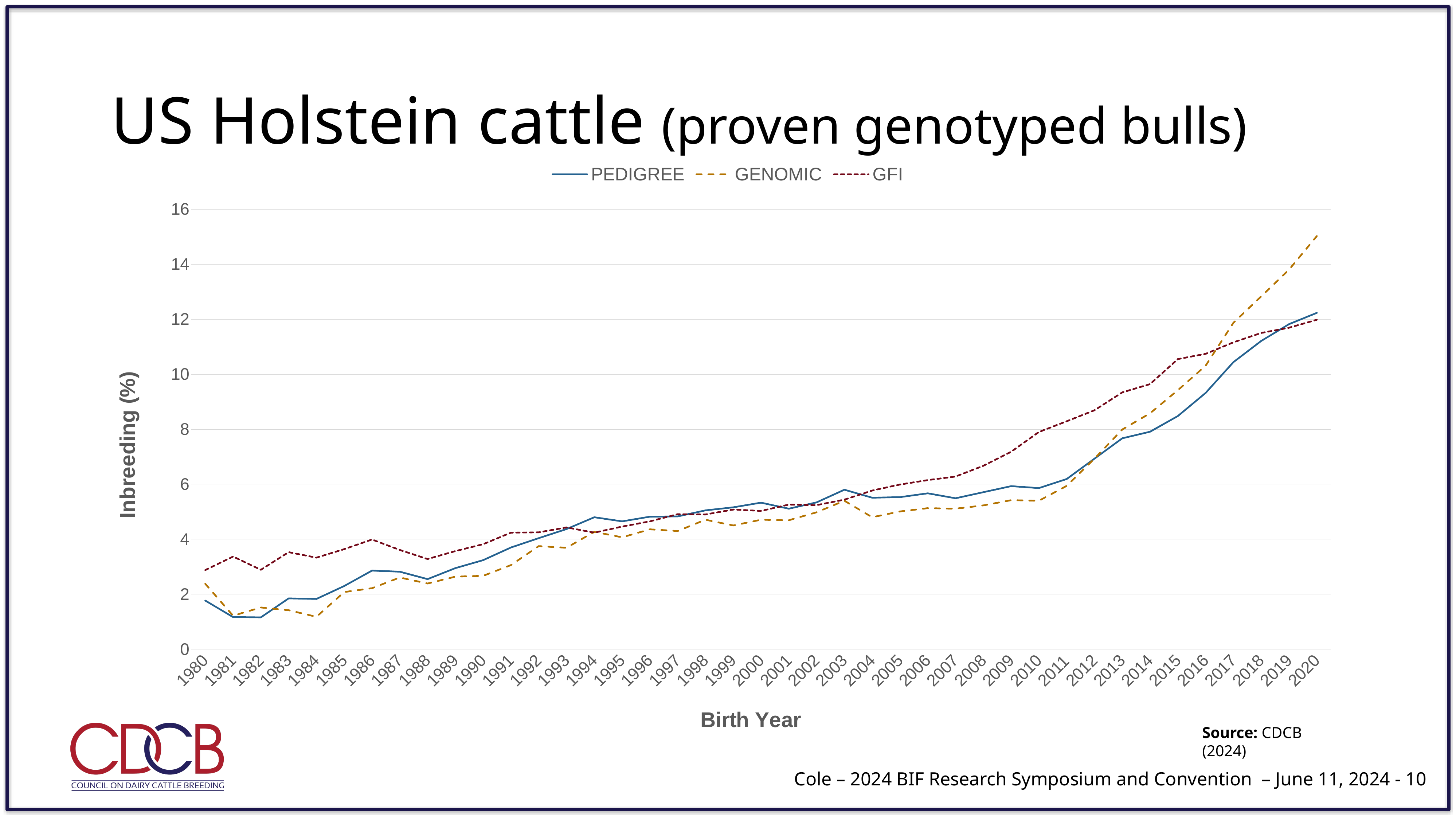
How many series does the legend list? 3 What kind of chart is shown on the slide? line chart Which series has the lowest value in 1980? PEDIGREE What is the label of the x axis? Birth Year Is the GFI value for 2015 greater or less than 10? greater Is the GENOMIC value for 2020 greater or less than 14? greater What is the label of the y axis? Inbreeding (%) Is the PEDIGREE value for 1980 greater or less than 2? less How many birth years are plotted along the x axis? 41 In 2008, which is larger, the GFI value or the GENOMIC value? GFI Does the PEDIGREE inbreeding value generally rise or fall from 1980 to 2020? rise Which series has the highest value in 2020? GENOMIC